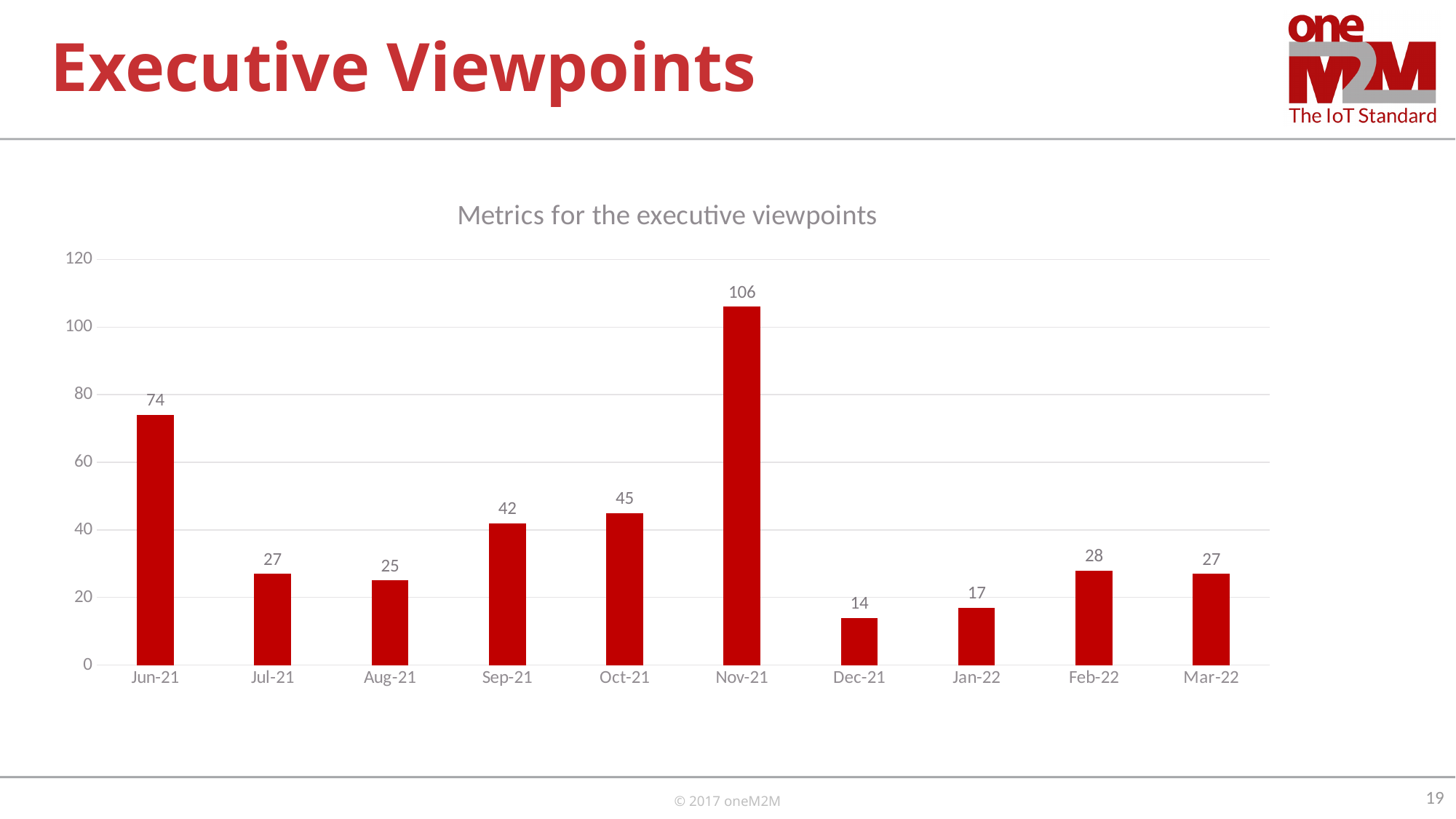
What is the value for Dec-21? 14 What is the value for Nov-21? 106 What is the value for Jun-21? 74 Which is larger, the value for Sep-21 or the value for Feb-22? Sep-21 What kind of chart is shown on the slide? Bar chart How many months are shown on the x axis? 10 What is the difference between the values for Nov-21 and Jun-21? 32 Which month has the lowest value? Dec-21 Is the value for Oct-21 greater or less than 40? greater What is the difference between the values for Oct-21 and Sep-21? 3 Which month has the highest value? Nov-21 What is the title of the chart? Metrics for the executive viewpoints